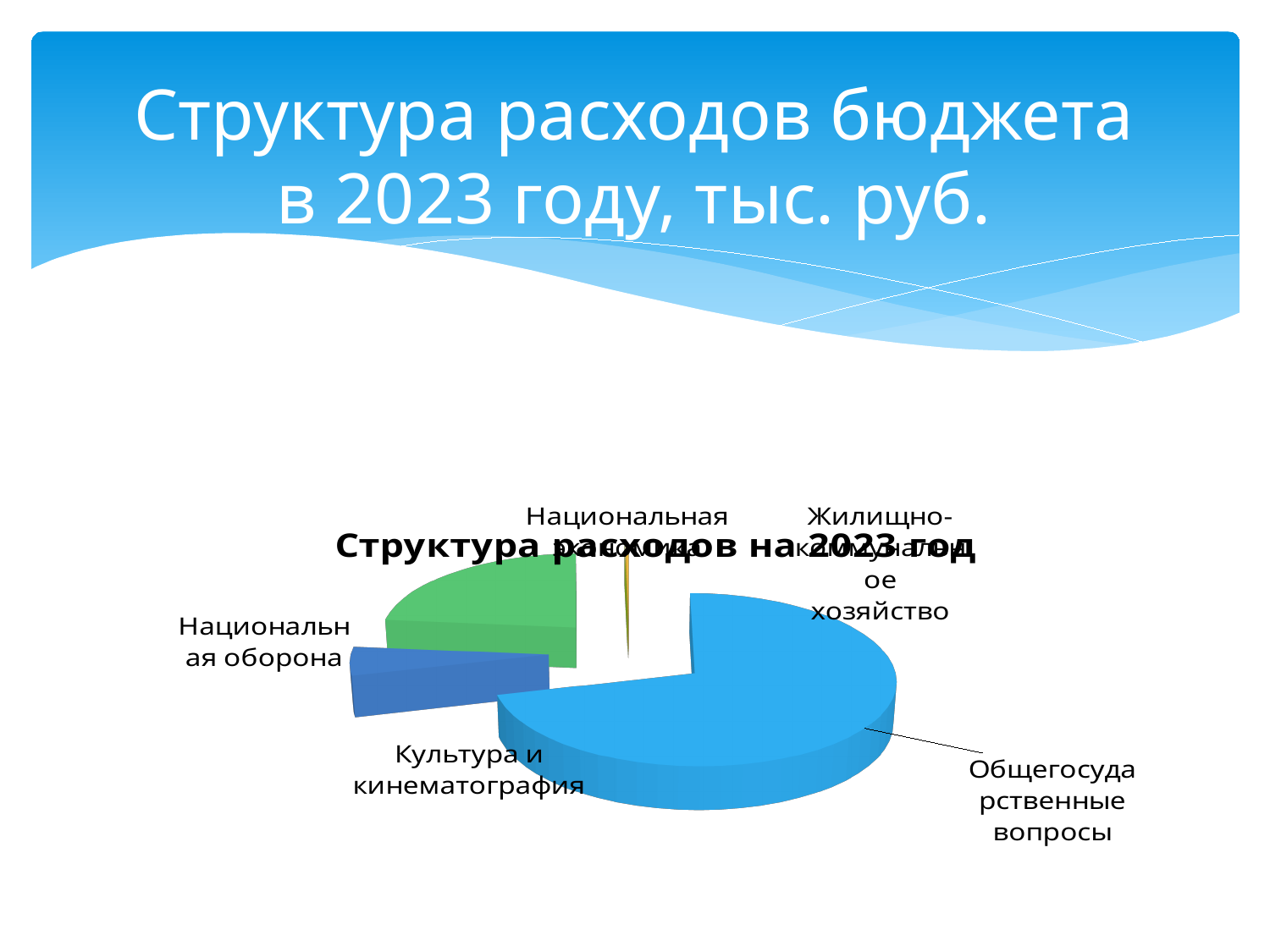
Which slice is larger: Общегосударственные вопросы or Культура и кинематография? Общегосударственные вопросы Which slice is larger: Культура и кинематография or Национальная оборона? Национальная оборона Which category has the largest slice in the pie chart? Общегосударственные вопросы What colour is the slice for Общегосударственные вопросы? blue How many categories are shown in the pie chart? 5 What is the title of the chart? Структура расходов на 2023 год What kind of chart is shown on the slide? pie chart